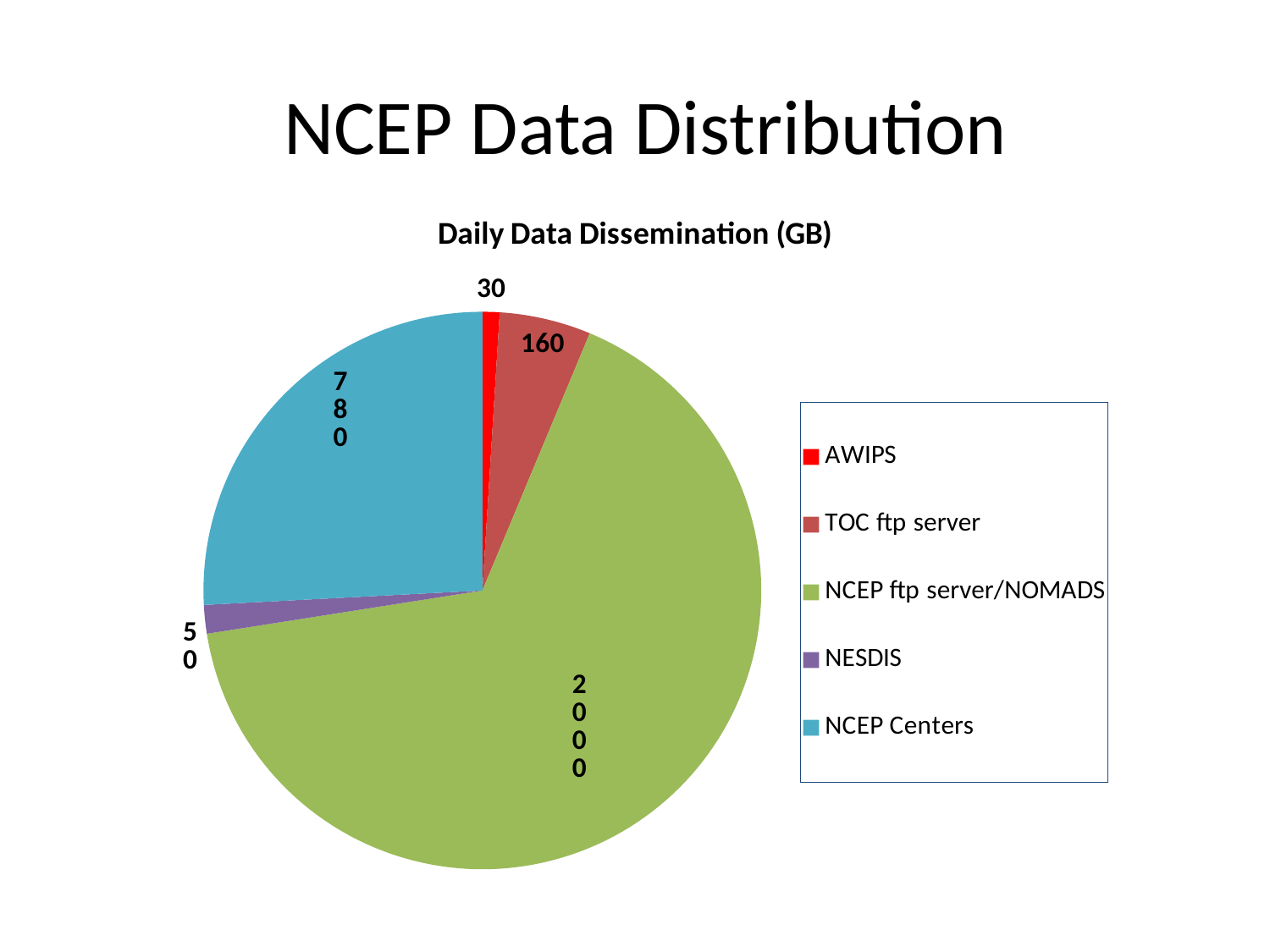
How many categories does the legend list? 5 What is the title of the chart? Daily Data Dissemination (GB) Which category has the smallest slice? AWIPS What is the value for NCEP ftp server/NOMADS? 2000 Which is larger, the value for TOC ftp server or the value for NESDIS? TOC ftp server What is the difference between the values for NCEP ftp server/NOMADS and NCEP Centers? 1220 Which category has the largest slice? NCEP ftp server/NOMADS What is the value for TOC ftp server? 160 What is the value for NESDIS? 50 What type of chart is shown on the slide? pie chart What is the value for NCEP Centers? 780 What is the value for AWIPS? 30